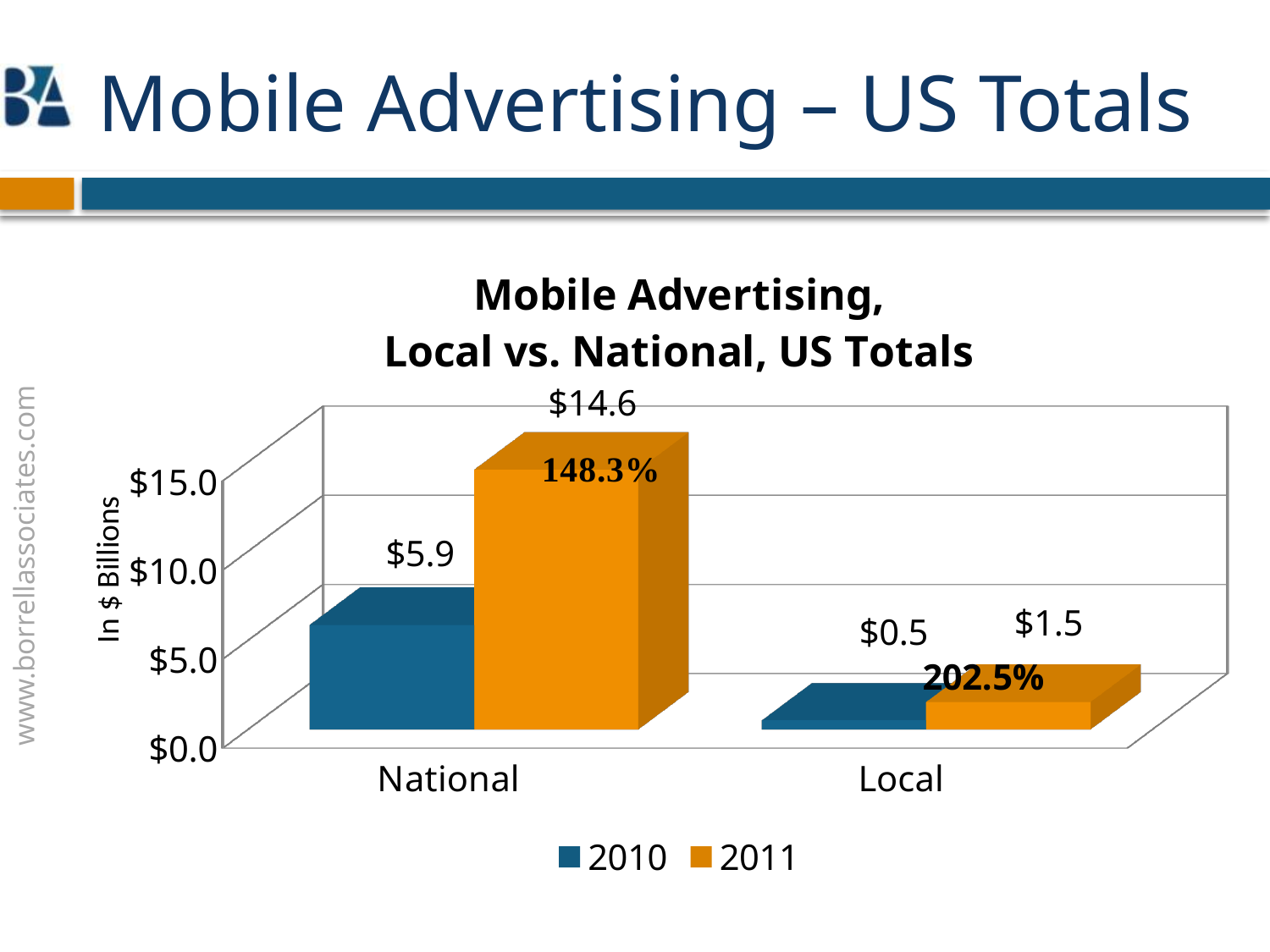
What percentage growth is labelled for the Local category? 202.5% What kind of chart is shown? Bar chart What is the 2011 value for Local? $1.5 What is the 2011 value for National? $14.6 Which category has the highest 2011 value? National What is the 2010 value for National? $5.9 What is the difference between the 2011 and 2010 values for National? $8.7 What is the 2010 value for Local? $0.5 How many series does the legend list? 2 How many categories are shown on the x axis? 2 Which category has the lowest 2010 value? Local Which is larger, the 2011 value for Local or the 2010 value for National? 2010 value for National